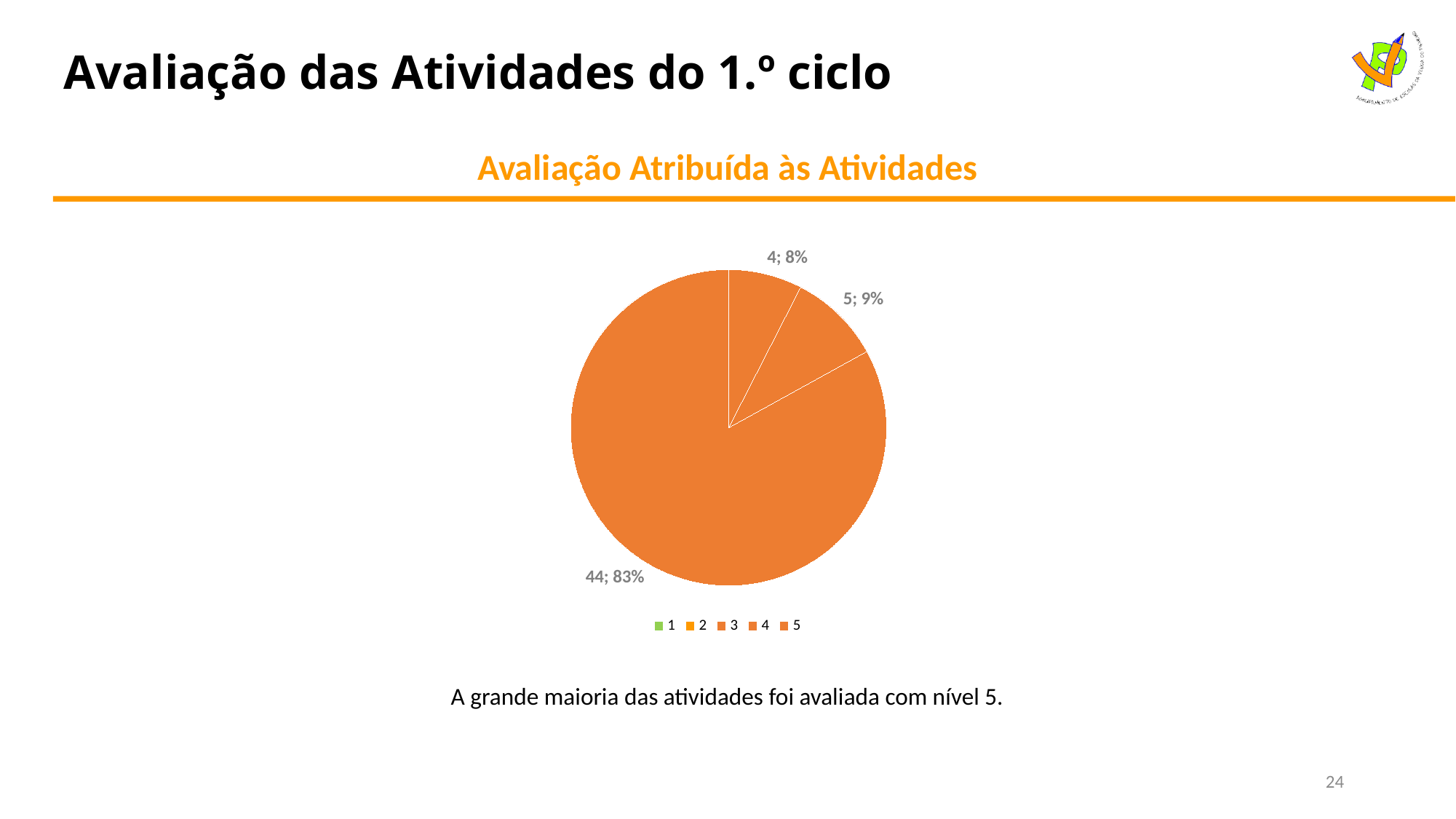
What is the percentage share of the smallest visible slice of the pie? 8% Which is larger: the slice labelled 8% or the slice labelled 9%? The slice labelled 9% According to the slide text, which level was assigned to the great majority of activities? Level 5 What is the total count across the three labelled slices (4, 5 and 44)? 53 What count is shown for the largest slice of the pie? 44 What is the title of the chart? Avaliação Atribuída às Atividades How many entries does the chart legend list? 5 What is the difference in count between the largest slice (44) and the slice with 5? 39 What count is shown for the slice labelled 9%? 5 How many slices are visible in the pie chart? 3 What is the percentage share of the largest slice of the pie? 83% What kind of chart is shown on the slide? Pie chart